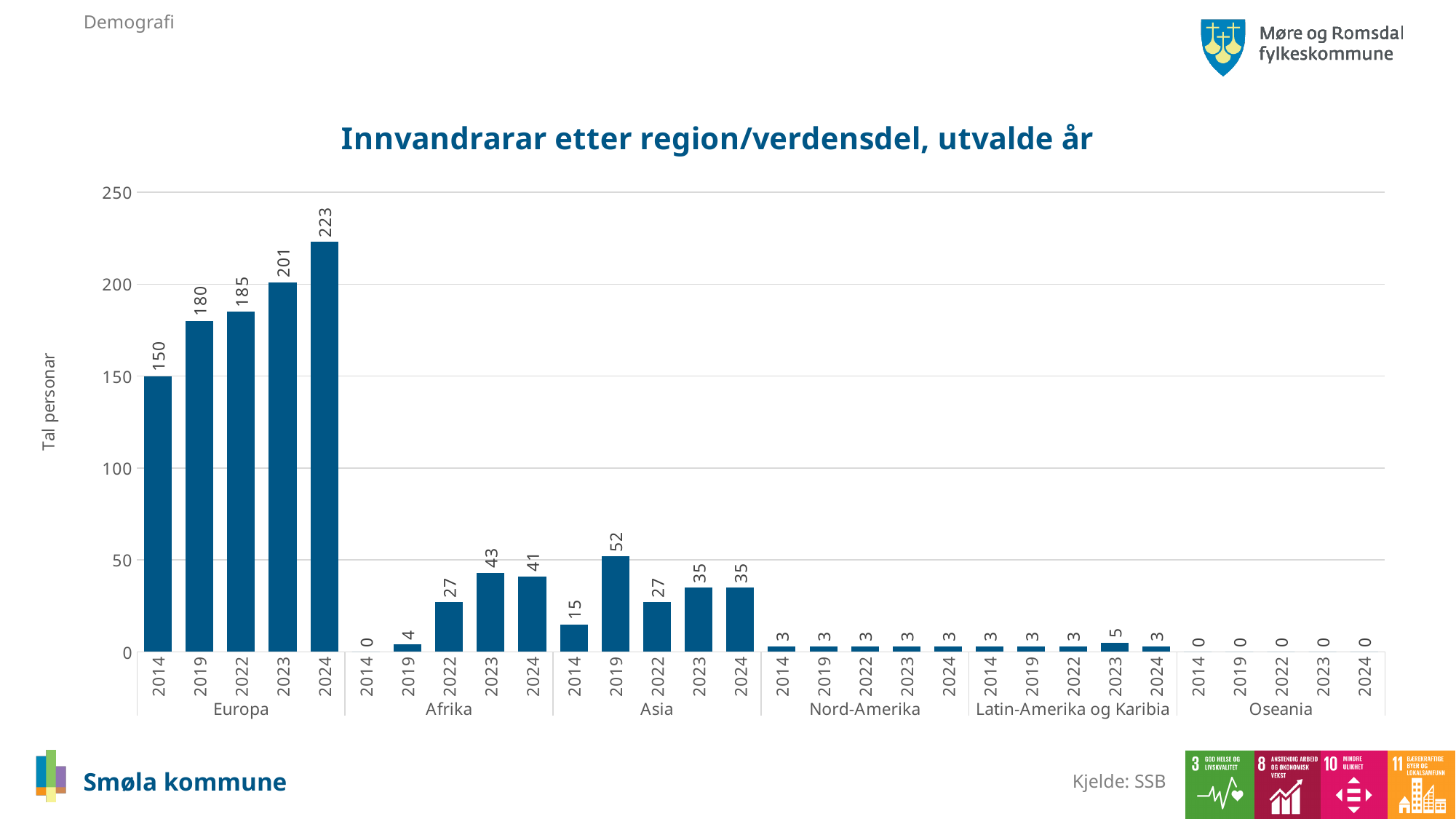
How many regions are shown on the x axis? 6 Is the value for Europa in 2023 greater or less than 200? greater What is the difference between the Europa values for 2024 and 2014? 73 Do the Europa values rise or fall from 2014 to 2024? rise What is the value for Europa in 2024? 223 Which is larger, the Afrika value for 2023 or the Asia value for 2023? Afrika 2023 What is the value for Asia in 2019? 52 What is the value for Afrika in 2014? 0 What is the value for Latin-Amerika og Karibia in 2023? 5 Which region has the highest bar in the chart? Europa Which region shows 0 for every year? Oseania What kind of chart is this? bar chart